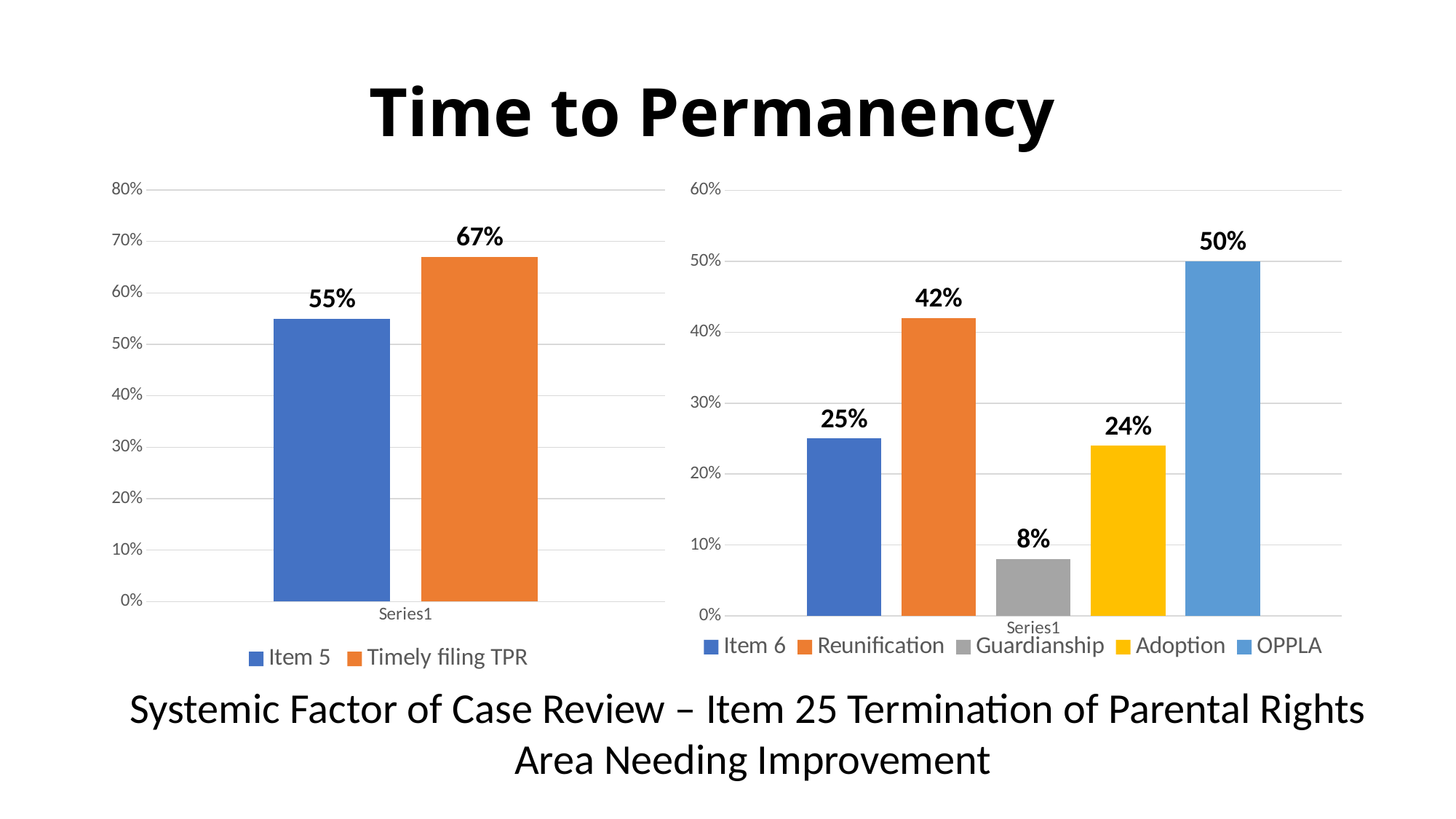
In the left chart, what is the difference between Timely filing TPR and Item 5? 12% In the right chart, which series has the lowest value? Guardianship In the right chart, what is the difference between OPPLA and Adoption? 26% In the right chart, which is larger, Item 6 or Reunification? Reunification In the right chart, which series has the highest value? OPPLA In the right chart, how many series does the legend list? 5 What kind of chart is the right chart? Bar chart In the right chart, what is the value for Guardianship? 8% In the left chart, what is the value for Timely filing TPR? 67% In the left chart, what is the value for Item 5? 55% In the left chart, how many series does the legend list? 2 In the right chart, what is the value for Reunification? 42%